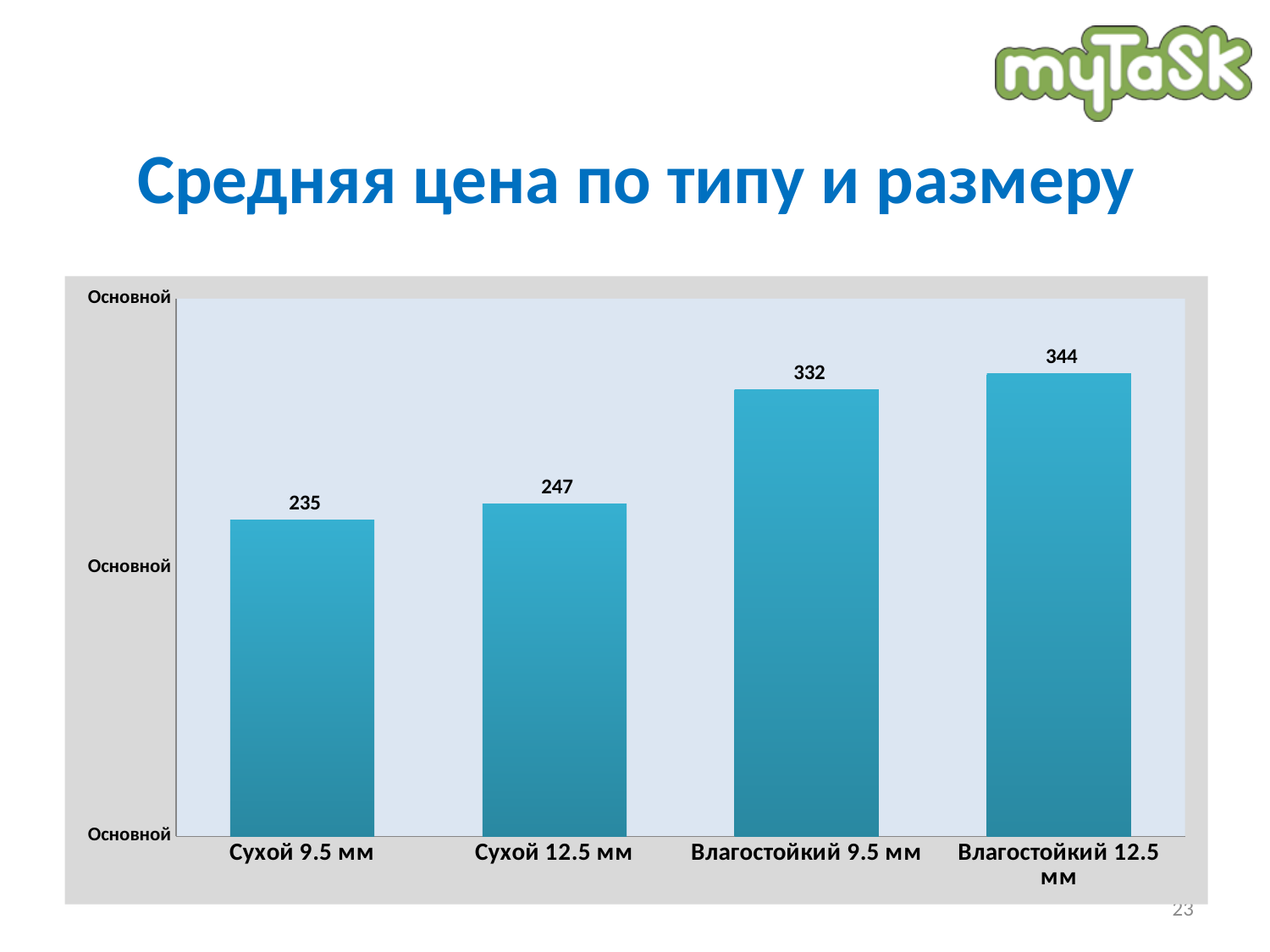
What is the value for Сухой 12.5 мм? 247 Which category has the highest value? Влагостойкий 12.5 мм Which is larger, the value for Сухой 12.5 мм or the value for Влагостойкий 9.5 мм? Влагостойкий 9.5 мм What is the difference between the values for Влагостойкий 12.5 мм and Сухой 12.5 мм? 97 What is the title of the slide? Средняя цена по типу и размеру What is the value for Влагостойкий 9.5 мм? 332 What kind of chart is shown on the slide? Bar chart What is the value for Сухой 9.5 мм? 235 How many categories are shown on the chart? 4 What is the difference between the values for Влагостойкий 9.5 мм and Сухой 9.5 мм? 97 What is the value for Влагостойкий 12.5 мм? 344 Which category has the lowest value? Сухой 9.5 мм